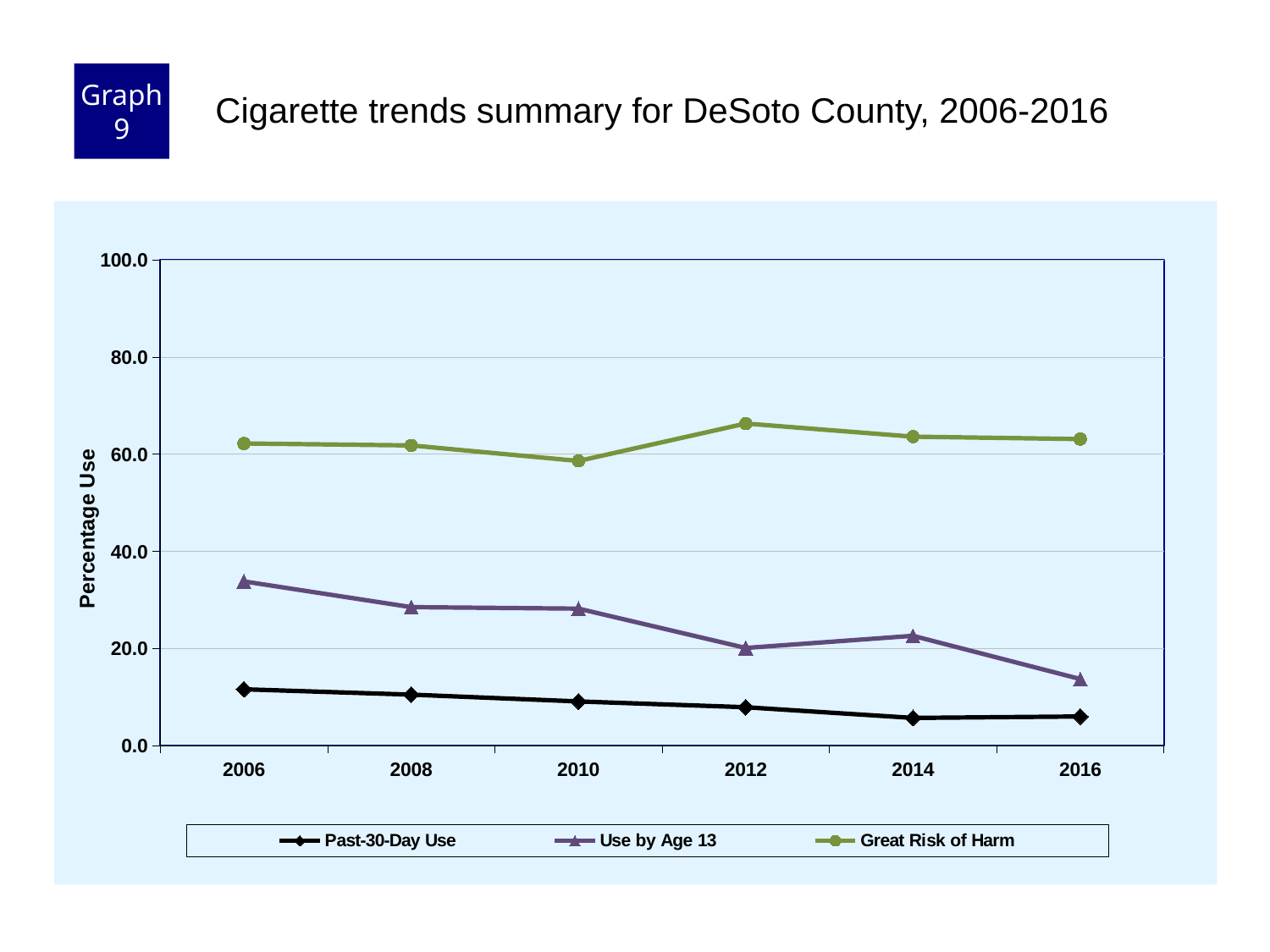
In which year is Great Risk of Harm at its lowest? 2010 Is the value for Past-30-Day Use in 2006 greater or less than 20.0? less What kind of chart is shown on the slide? line chart Is the value for Use by Age 13 in 2006 greater or less than 40.0? less Is the value for Great Risk of Harm in 2010 greater or less than 60.0? less What is the label on the y axis? Percentage Use Does Past-30-Day Use generally rise or fall from 2006 to 2016? fall How many series does the legend list? 3 In which year is Use by Age 13 at its lowest? 2016 How many years are plotted along the x axis? 6 In which year is Great Risk of Harm at its highest? 2012